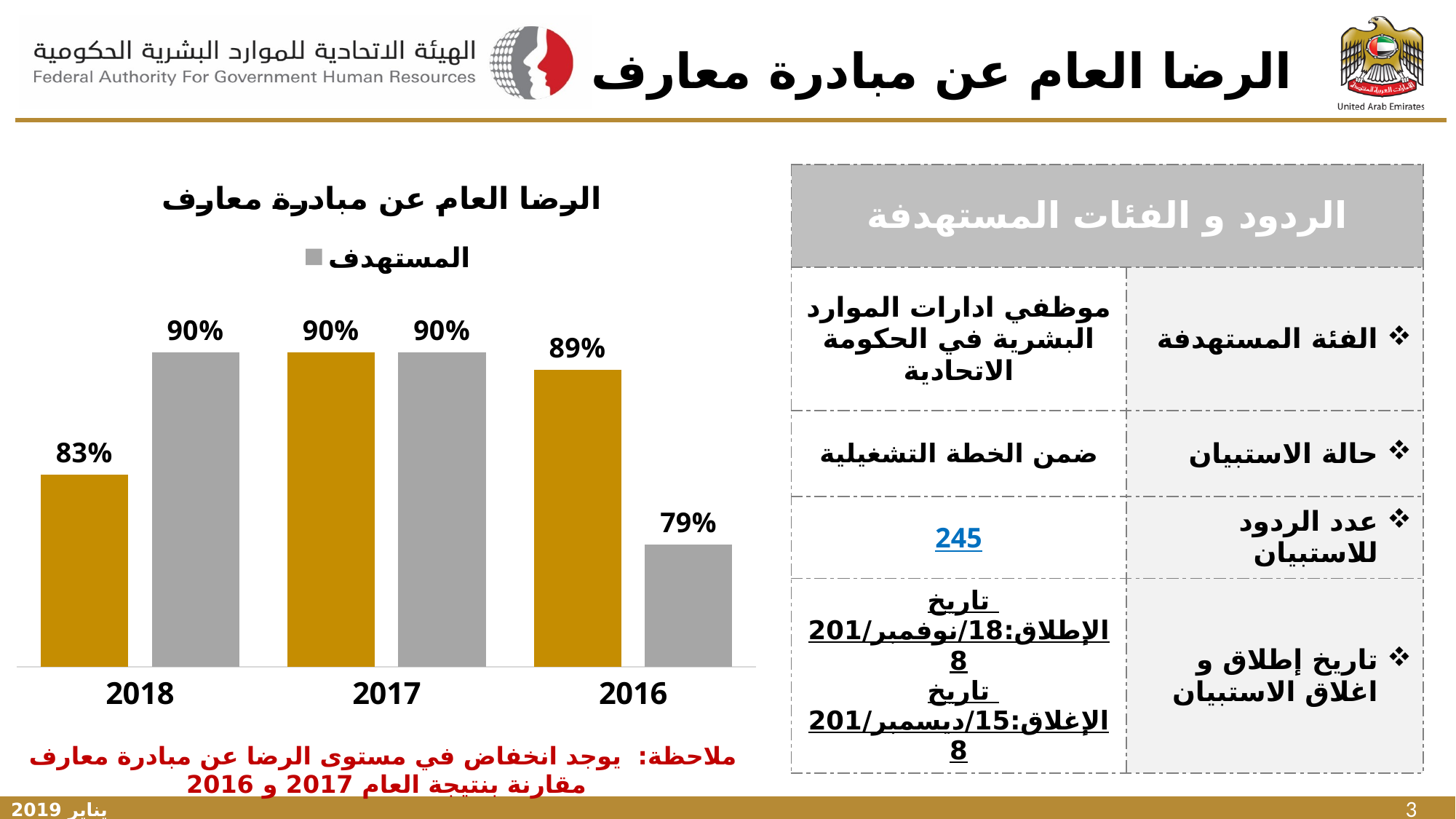
What is the value of the gray (المستهدف) bar for 2018? 90% Which year has the lowest value for the gray (المستهدف) series? 2016 What is the difference between the gray (المستهدف) bar and the gold bar for 2018? 7% What type of chart is shown on the slide? bar chart What is the value of the gray (المستهدف) bar for 2016? 79% What is the title of the chart? الرضا العام عن مبادرة معارف What is the value of the gold bar for 2017? 90% What is the value of the gold bar for 2018? 83% Which year has the lowest value for the gold series? 2018 How many year categories are shown on the x axis of the chart? 3 For 2016, which is larger: the gold bar or the gray (المستهدف) bar? the gold bar What is the value of the gold bar for 2016? 89%